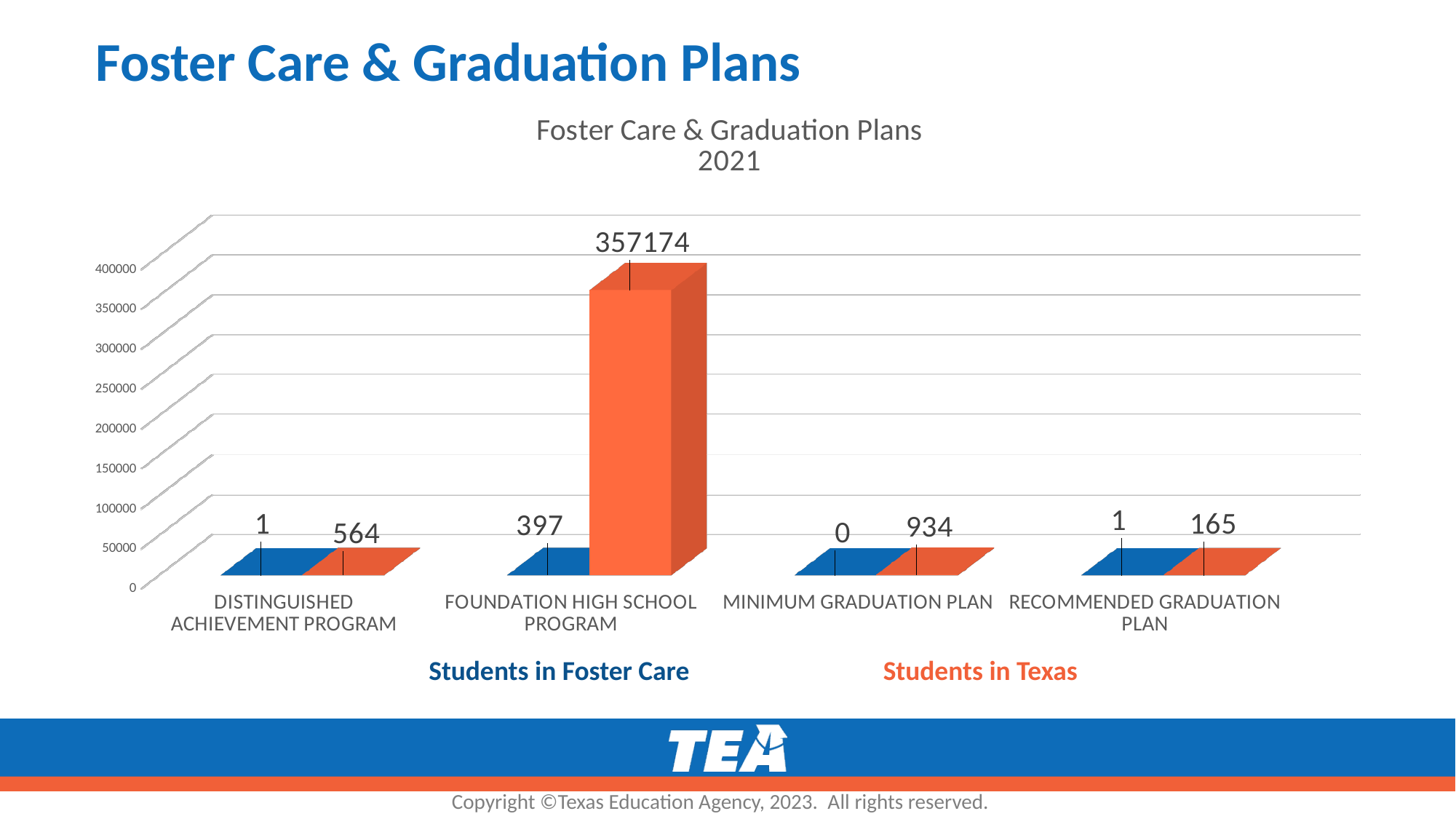
Which category has the lowest value for Students in Foster Care? Minimum Graduation Plan How many categories are shown on the x axis? 4 What is the difference between the Students in Texas values for the Minimum Graduation Plan and the Recommended Graduation Plan? 769 What kind of chart is shown on the slide? Bar chart What is the value for Students in Texas in the Minimum Graduation Plan? 934 Which is larger: the Students in Texas value for the Distinguished Achievement Program or for the Minimum Graduation Plan? Minimum Graduation Plan What is the value for Students in Foster Care in the Foundation High School Program? 397 What is the value for Students in Texas in the Foundation High School Program? 357174 How many series does the legend list? 2 What is the value for Students in Foster Care in the Minimum Graduation Plan? 0 Which category has the highest value for Students in Texas? Foundation High School Program What is the value for Students in Texas in the Recommended Graduation Plan? 165